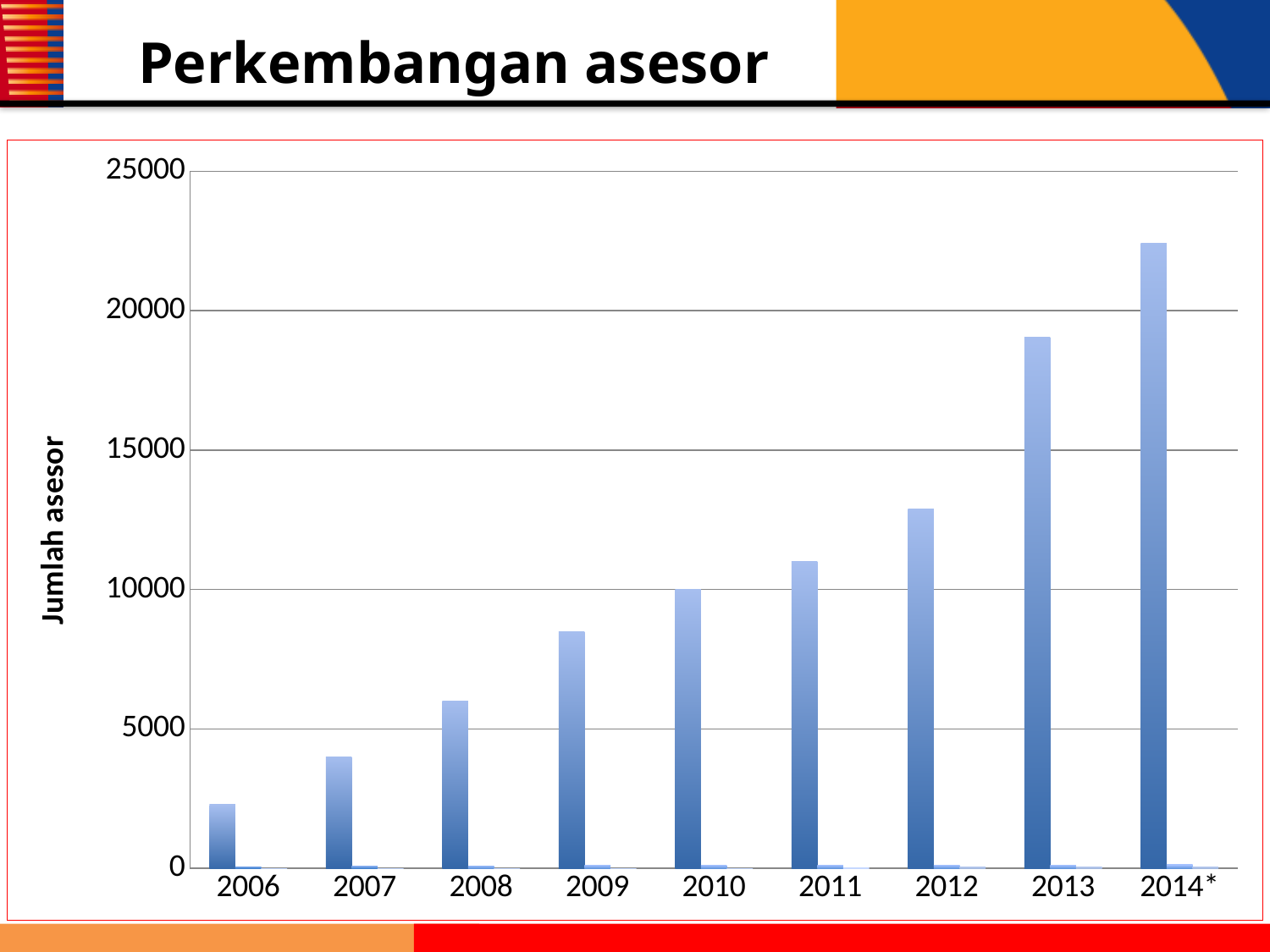
Is the value for 2012 greater or less than 10000? greater How many years are shown on the x axis of the chart? 9 Which year has a larger value, 2008 or 2011? 2011 Is the value for 2013 greater or less than 20000? less Is the value for 2006 greater or less than 5000? less What is the title of the y axis? Jumlah asesor Do the values rise or fall from 2006 to 2014*? rise Which year has the lowest number of asesor? 2006 Which year has the highest number of asesor? 2014* What kind of chart is shown on the slide? bar chart